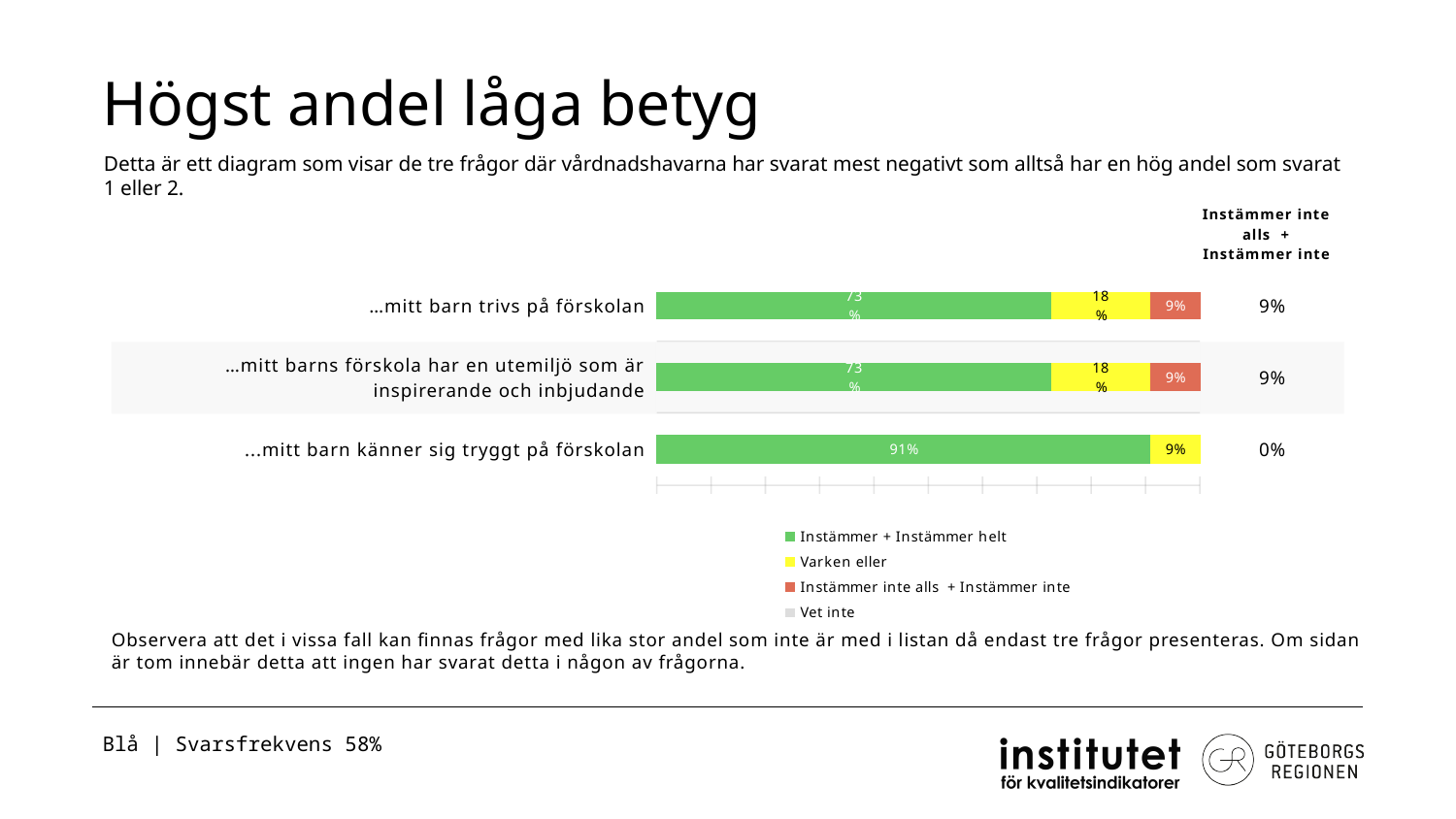
What is the yellow "Varken eller" value for "…mitt barns förskola har en utemiljö som är inspirerande och inbjudande"? 18% What is the green "Instämmer + Instämmer helt" value for "…mitt barn trivs på förskolan"? 73% What kind of chart is shown on the slide? stacked bar chart How many series does the legend list? 4 Which category has the lowest "Instämmer inte alls + Instämmer inte" value? …mitt barn känner sig tryggt på förskolan Which is larger: the yellow "Varken eller" value for "…mitt barn trivs på förskolan" or for "…mitt barn känner sig tryggt på förskolan"? …mitt barn trivs på förskolan What is the title of the slide containing the chart? Högst andel låga betyg What is the "Instämmer inte alls + Instämmer inte" value shown in the right-hand column for "…mitt barn känner sig tryggt på förskolan"? 0% What is the difference between the green values for "…mitt barn känner sig tryggt på förskolan" and "…mitt barn trivs på förskolan"? 18% What is the green "Instämmer + Instämmer helt" value for "…mitt barn känner sig tryggt på förskolan"? 91% Which category has the highest green "Instämmer + Instämmer helt" value? …mitt barn känner sig tryggt på förskolan How many categories (questions) are plotted in the chart? 3